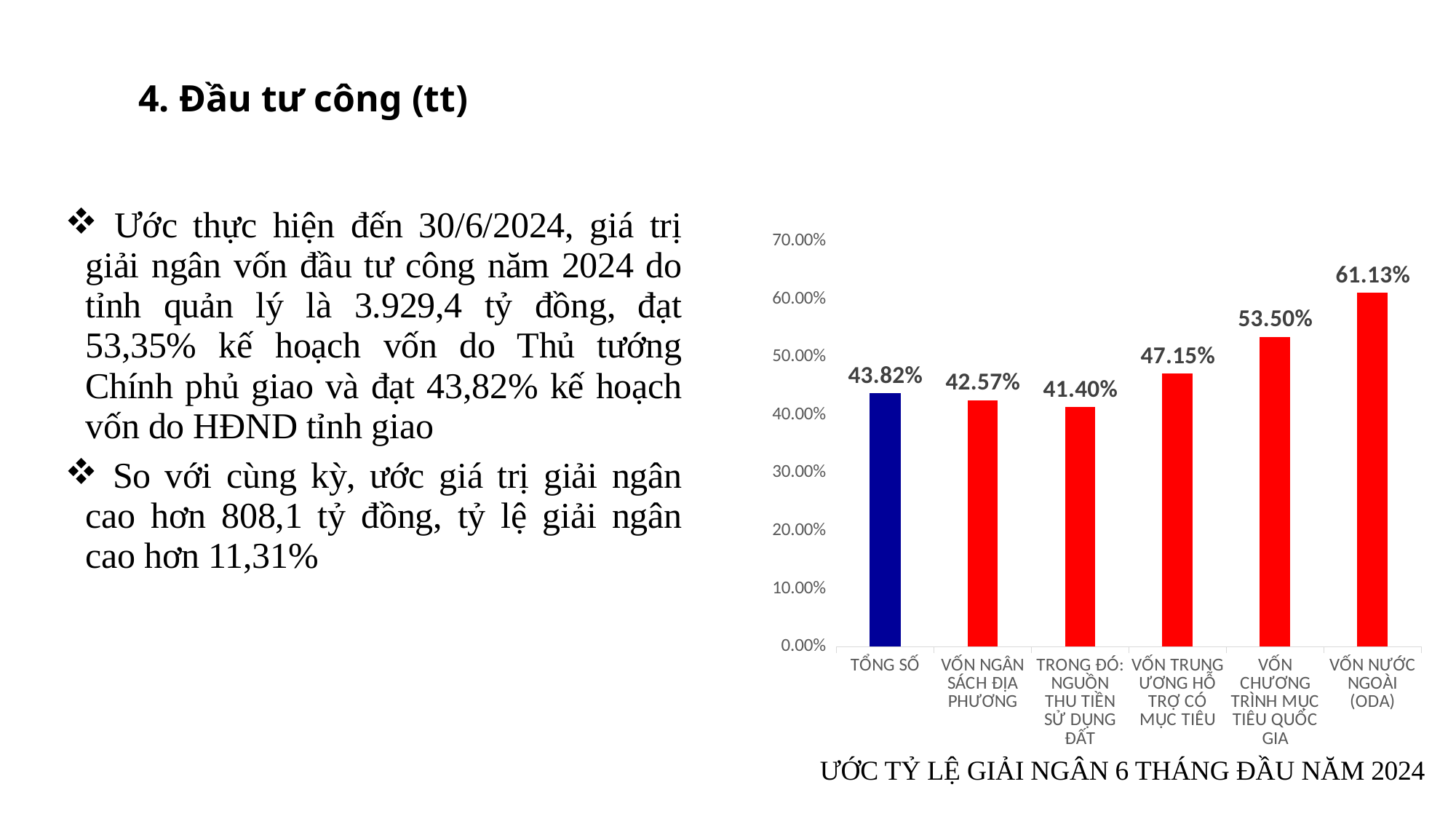
Which category has the lowest value? TRONG ĐÓ: NGUỒN THU TIỀN SỬ DỤNG ĐẤT Is the value for VỐN CHƯƠNG TRÌNH MỤC TIÊU QUỐC GIA greater or less than 50.00%? greater What is the value for VỐN TRUNG ƯƠNG HỖ TRỢ CÓ MỤC TIÊU? 47.15% Which bar is coloured differently from the others? TỔNG SỐ What is the title of the chart? ƯỚC TỶ LỆ GIẢI NGÂN 6 THÁNG ĐẦU NĂM 2024 What is the value for VỐN NƯỚC NGOÀI (ODA)? 61.13% What is the difference between the values for VỐN NƯỚC NGOÀI (ODA) and TỔNG SỐ? 17.31% What kind of chart is shown on the slide? bar chart How many categories are shown on the chart? 6 What is the value for TỔNG SỐ? 43.82% Which is larger, the value for VỐN CHƯƠNG TRÌNH MỤC TIÊU QUỐC GIA or the value for VỐN NGÂN SÁCH ĐỊA PHƯƠNG? VỐN CHƯƠNG TRÌNH MỤC TIÊU QUỐC GIA Which category has the highest value? VỐN NƯỚC NGOÀI (ODA)